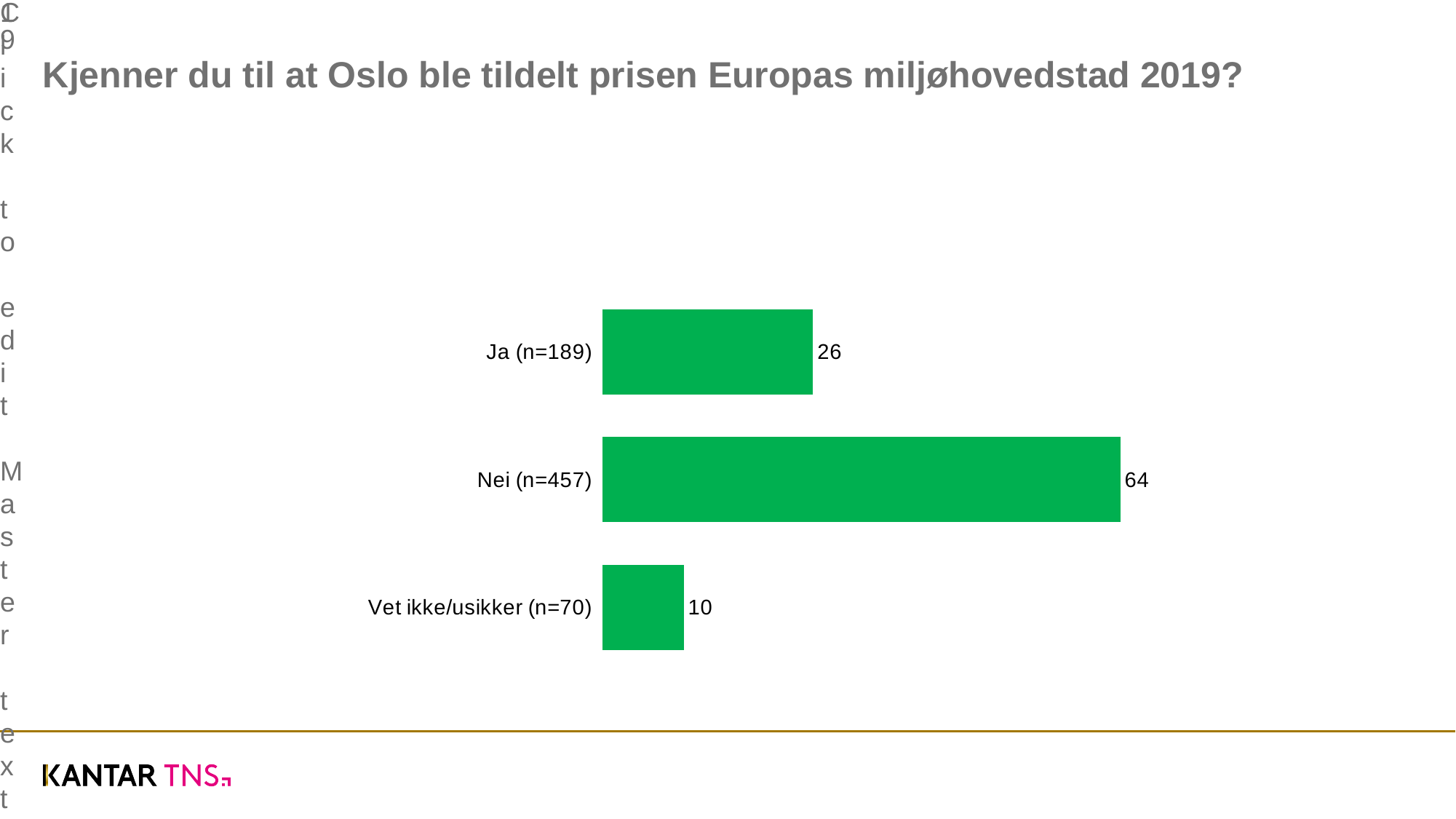
What is the difference between the values for Nei (n=457) and Ja (n=189)? 38 What colour are the bars in the chart? Green Which category has the highest value? Nei (n=457) What is the value for Nei (n=457)? 64 Which is larger, the value for Ja (n=189) or the value for Vet ikke/usikker (n=70)? Ja (n=189) What is the value for Ja (n=189)? 26 How many categories are shown in the chart? 3 What is the title of the slide? Kjenner du til at Oslo ble tildelt prisen Europas miljøhovedstad 2019? What kind of chart is shown on the slide? Bar chart Which category has the lowest value? Vet ikke/usikker (n=70) What is the difference between the values for Ja (n=189) and Vet ikke/usikker (n=70)? 16 What is the value for Vet ikke/usikker (n=70)? 10